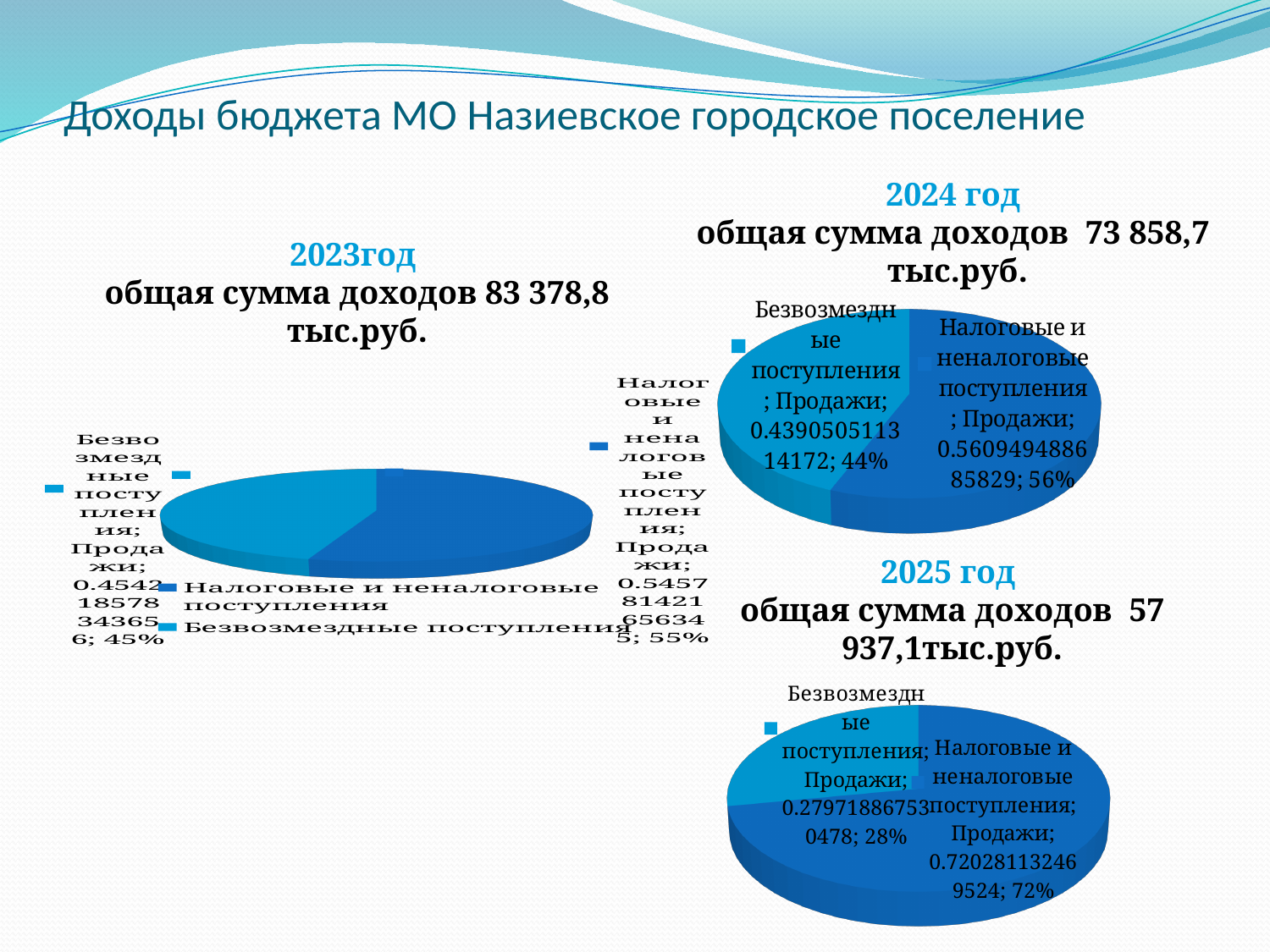
In the 2024 год chart, what share of the pie is Налоговые и неналоговые поступления? 56% In the 2023 год chart, what share of the pie is Безвозмездные поступления? 45% In the 2024 год chart, which category has the smallest slice? Безвозмездные поступления How many pie charts are on the slide? 3 How many categories does the 2024 год pie chart show? 2 In the 2025 год chart, what share of the pie is Налоговые и неналоговые поступления? 72% In the 2025 год chart, what is the difference in percentage points between Налоговые и неналоговые поступления and Безвозмездные поступления? 44 percentage points In the 2025 год chart, which category has the largest slice? Налоговые и неналоговые поступления What type of chart is used for the 2023 год data? Pie chart